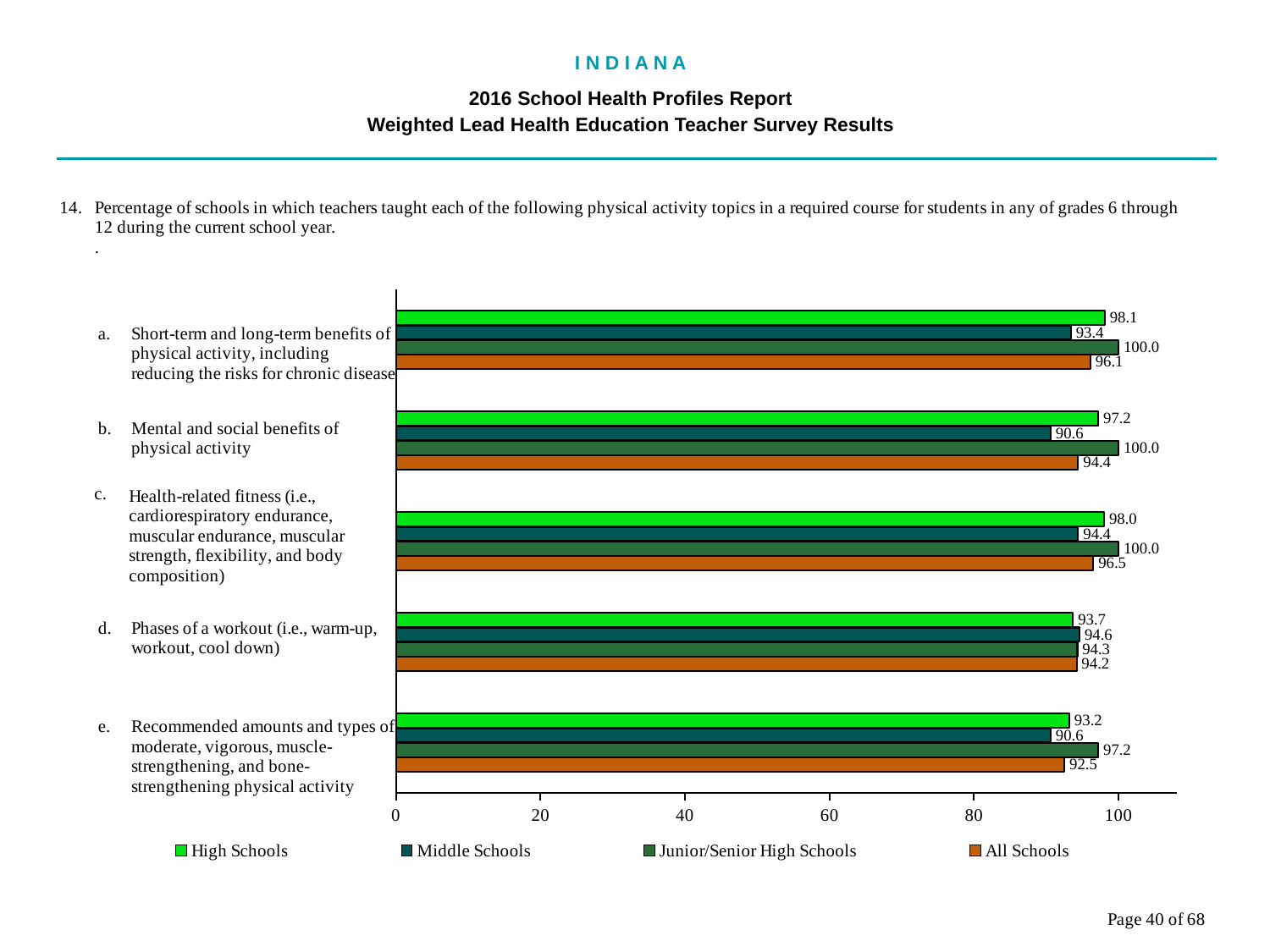
How many series does the legend list? 4 Which topic has the highest value for All Schools? c. Health-related fitness What is the difference between the Junior/Senior High Schools and Middle Schools values for topic b (mental and social benefits of physical activity)? 9.4 What is the value for Middle Schools for topic b (mental and social benefits of physical activity)? 90.6 How many physical activity topics are shown in the chart? 5 For topic e, which is larger: the High Schools value or the Junior/Senior High Schools value? Junior/Senior High Schools What is the value for High Schools for topic a (short-term and long-term benefits of physical activity)? 98.1 What kind of chart is shown on the slide? bar chart What is the value for All Schools for topic e (recommended amounts and types of physical activity)? 92.5 Is the Middle Schools value for topic a greater or less than 80? greater Which topic has the lowest value for High Schools? e. Recommended amounts and types of moderate, vigorous, muscle-strengthening, and bone-strengthening physical activity What is the value for Junior/Senior High Schools for topic d (phases of a workout)? 94.3